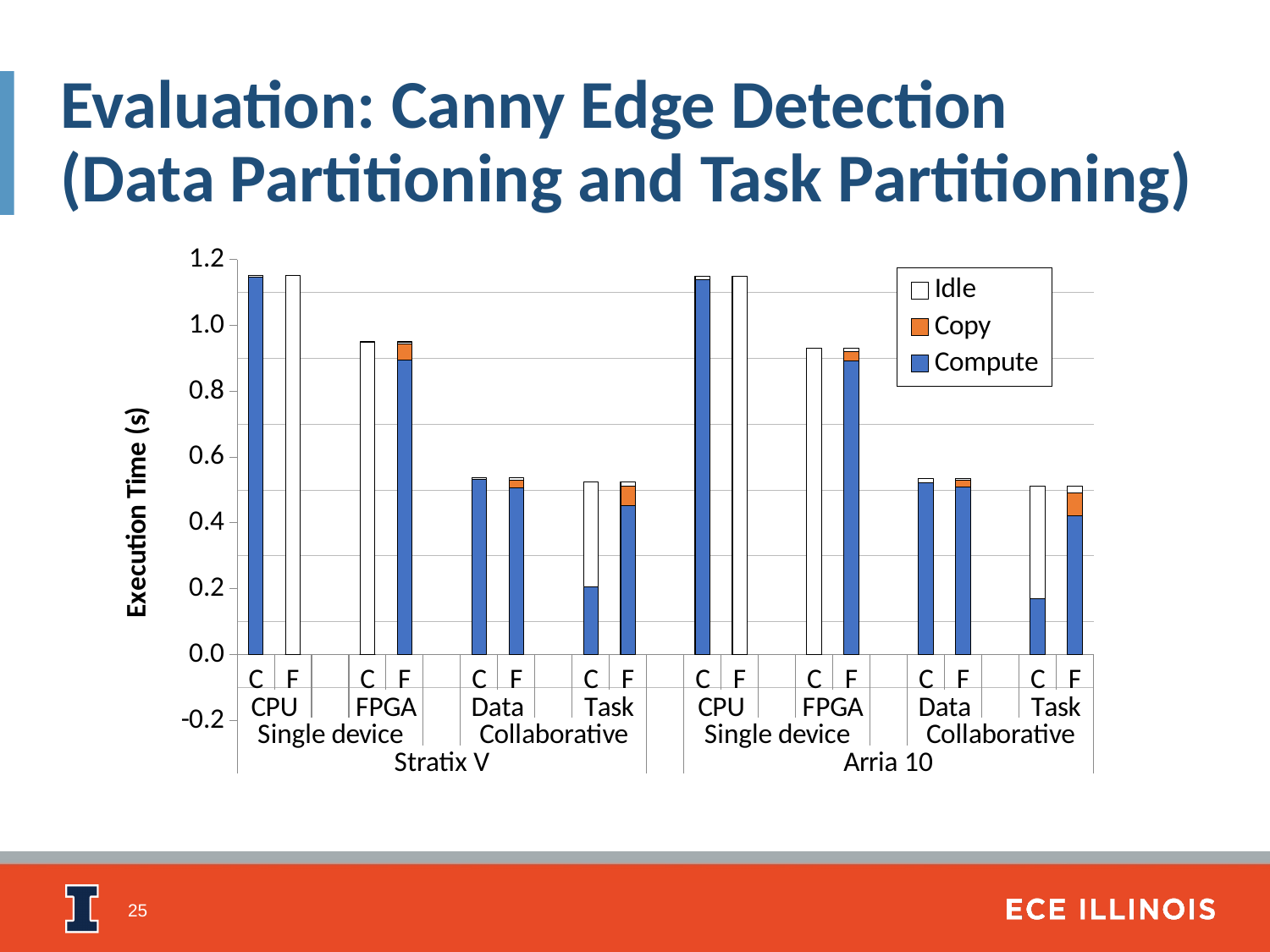
What kind of chart is shown on the slide? stacked bar chart Is the total execution time for the Stratix V Collaborative Task 'F' bar greater or less than 0.6? less Is the total execution time for the Stratix V Single device CPU 'C' bar greater or less than 1.0? greater How many FPGA platforms are compared along the x axis? 2 What are the three series named in the legend? Idle, Copy, Compute Is the total execution time for the Stratix V Single device FPGA 'F' bar greater or less than 1.0? less Which has the larger total execution time on Arria 10: the Single device FPGA 'F' bar or the Collaborative Task 'F' bar? Single device FPGA 'F' Which has the larger total execution time on Stratix V: the Single device CPU 'C' bar or the Collaborative Data 'C' bar? Single device CPU 'C' How many bars are plotted in total on the chart? 16 How many series does the legend list? 3 What is the label of the vertical axis? Execution Time (s)